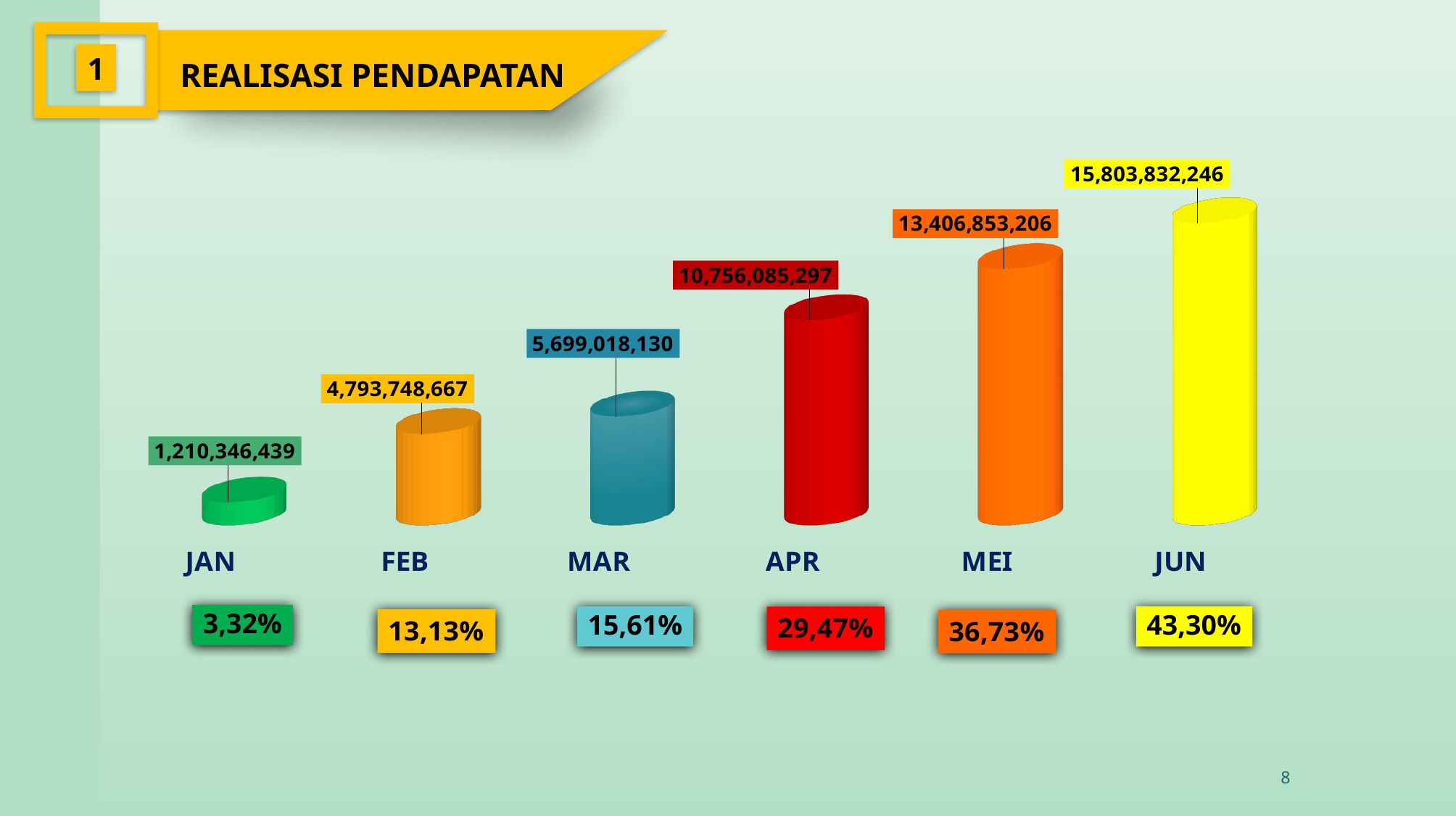
What percentage is shown below MEI? 36,73% Do the values rise or fall from JAN to JUN? Rise What kind of chart is shown on the slide? Bar chart What is the difference between the values for APR and MAR? 5,057,067,167 What is the difference between the values for JUN and MEI? 2,396,979,040 What is the value shown for JAN? 1,210,346,439 Which is larger, the value for FEB or the value for MAR? MAR How many months are shown in the chart? 6 What percentage is shown below MAR? 15,61% Which month has the highest value? JUN Which month has the lowest value? JAN What is the value shown for APR? 10,756,085,297